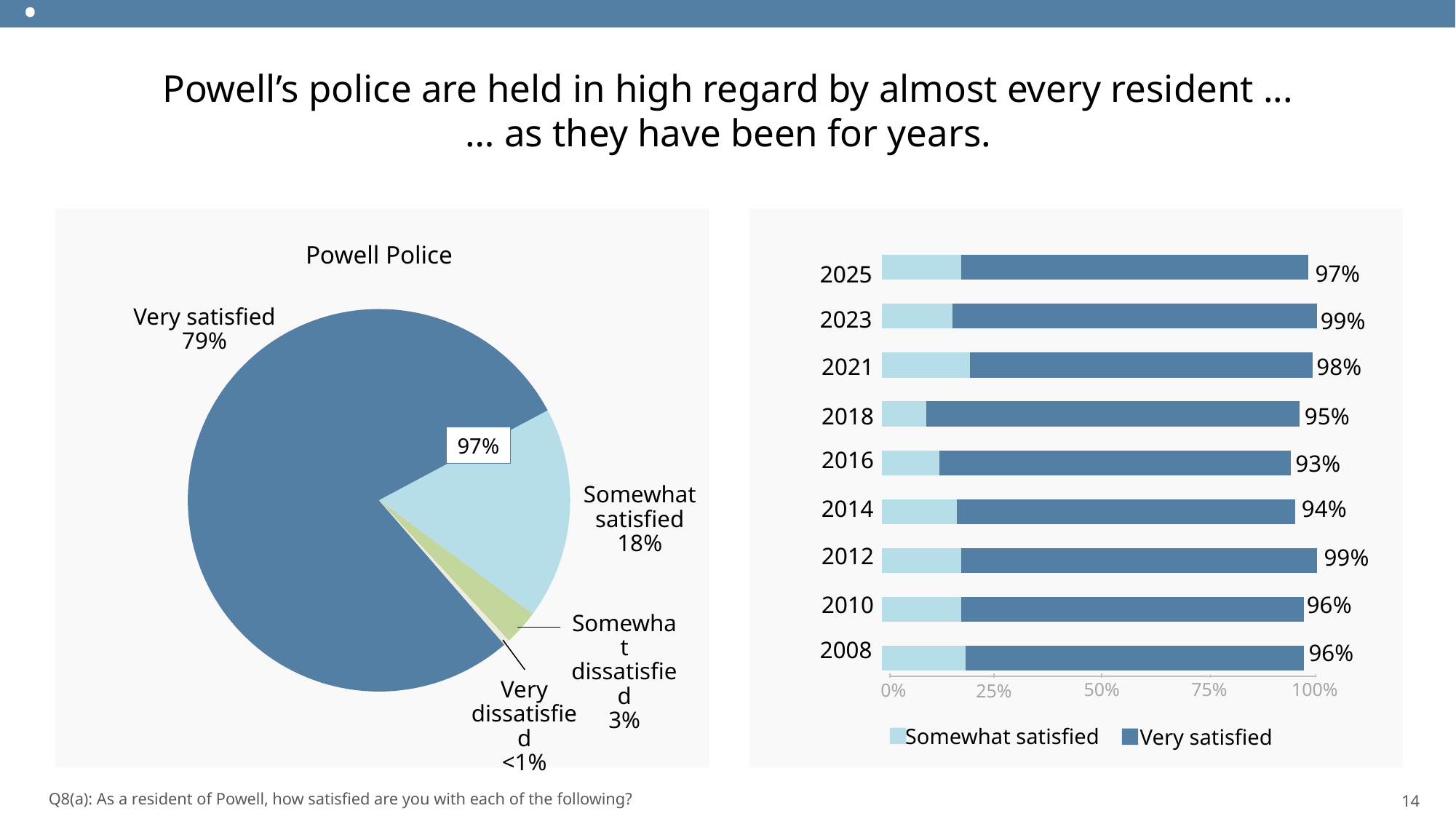
In the pie chart titled Powell Police, what share of residents are somewhat satisfied? 18% What kind of chart is the chart on the left of the slide? Pie chart In the pie chart titled Powell Police, what share of residents are somewhat dissatisfied? 3% In the pie chart titled Powell Police, what share of residents are very satisfied? 79% In the bar chart on the right, what is the difference between the total for 2023 and the total for 2018? 4% In the pie chart titled Powell Police, how many slices are there? 4 In the bar chart on the right, which year has the lowest total satisfied value? 2016 In the pie chart titled Powell Police, which slice is the largest? Very satisfied In the bar chart on the right, what is the total satisfied value labelled for 2025? 97% In the bar chart on the right, how many series does the legend list? 2 In the bar chart on the right, how many years are shown? 9 In the bar chart on the right, what is the total satisfied value labelled for 2016? 93%